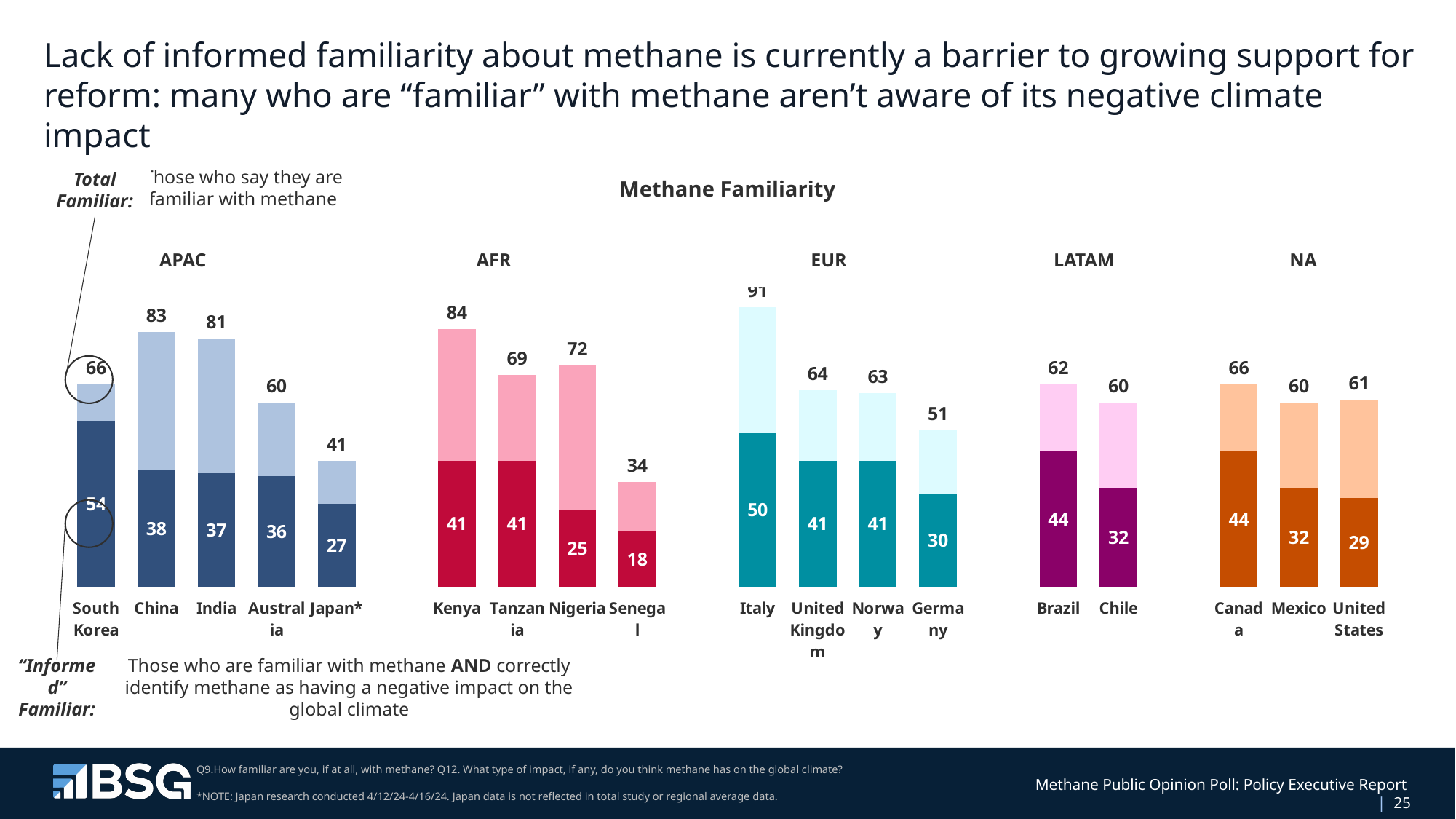
What is the title of the chart? Methane Familiarity Which has a higher "Informed" Familiar value, Brazil or Chile? Brazil What kind of chart is used to show Methane Familiarity? Stacked bar chart Which country in the APAC group has the lowest Total Familiar value? Japan* How many regional groups are labelled in the chart? 5 What is the "Informed" Familiar value for Senegal? 18 How many countries are shown in the chart? 18 What is the "Informed" Familiar value for Canada? 44 What is the Total Familiar value for Italy? 91 Which country has the highest Total Familiar value? Italy What is the difference between the Total Familiar and "Informed" Familiar values for China? 45 Which country has the lowest "Informed" Familiar value? Senegal